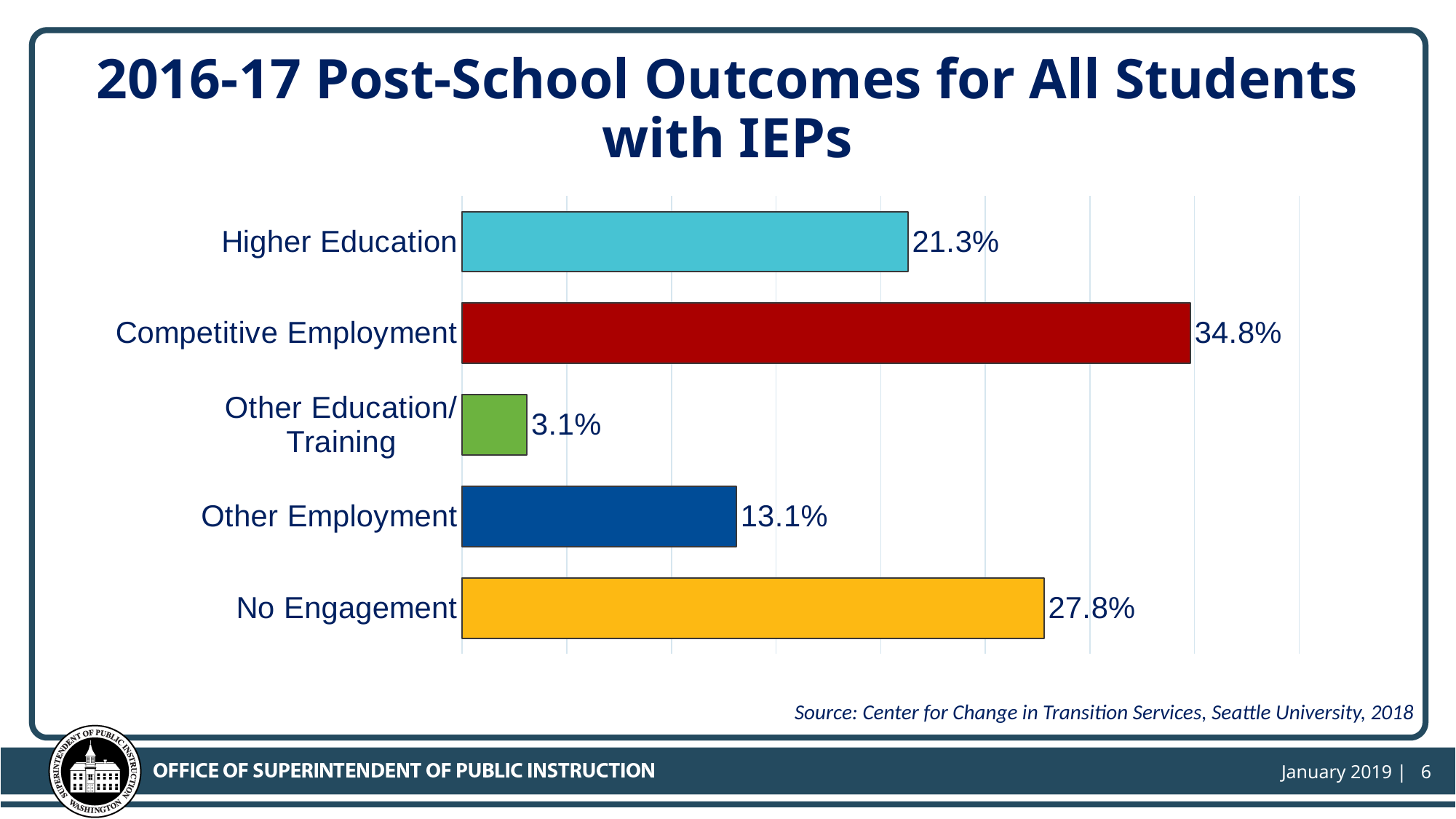
What is the value for Other Employment? 13.1% What is the difference between Competitive Employment and No Engagement? 7.0% What is the value for Higher Education? 21.3% Which category has the lowest value? Other Education/Training Which is larger, Higher Education or No Engagement? No Engagement What colour is the bar for Competitive Employment? Red What kind of chart is shown on the slide? Bar chart How many categories are shown in the chart? 5 Which category has the highest value? Competitive Employment What is the value for No Engagement? 27.8% What is the difference between Higher Education and Other Employment? 8.2% What is the value for Competitive Employment? 34.8%